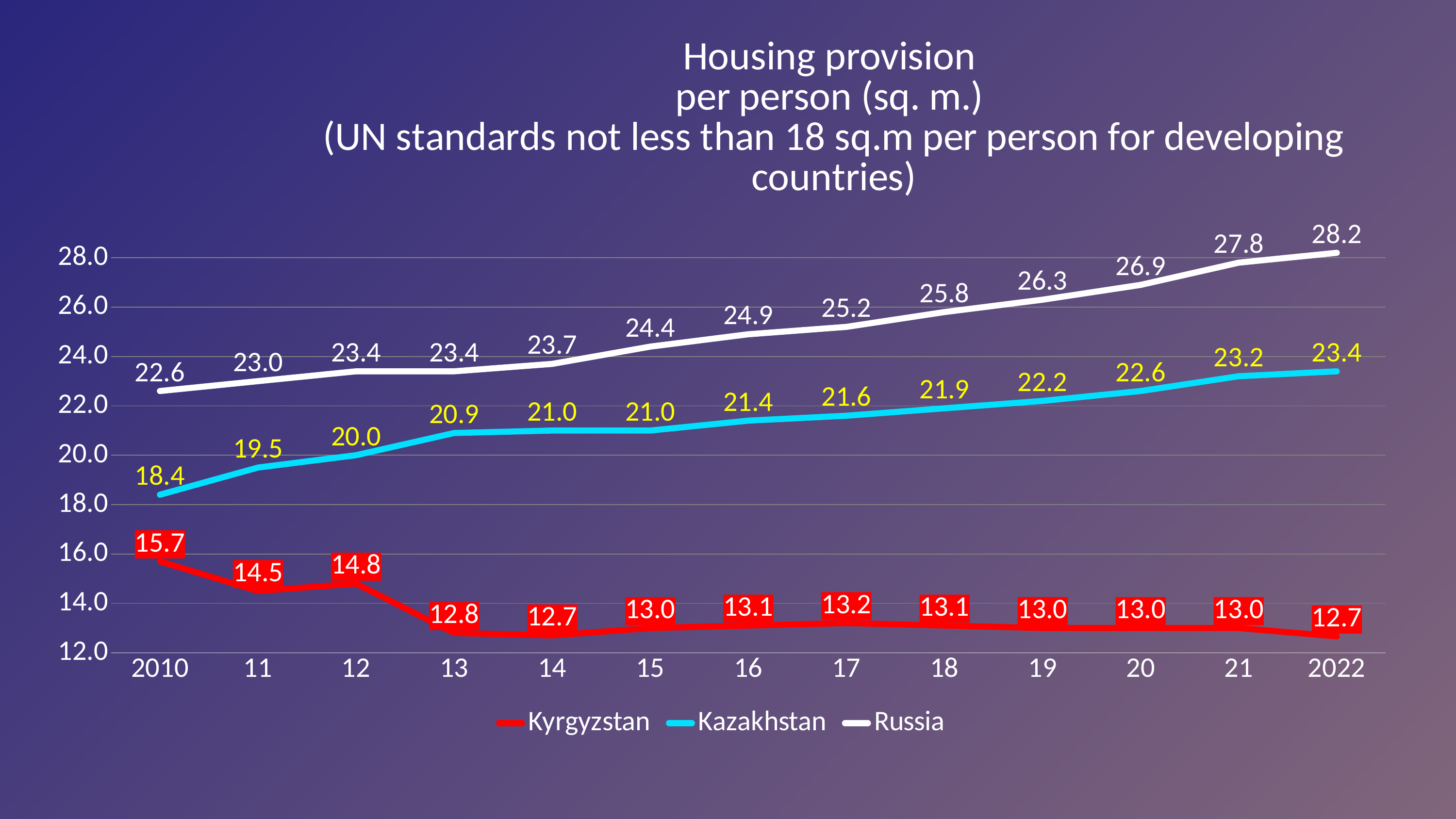
What is the housing provision per person for Kazakhstan in 2010? 18.4 In which year is the Russia value lowest? 2010 How many series does the legend list? 3 In which year is the Kyrgyzstan value highest? 2010 Does the Russia series rise or fall from 2010 to 2022? Rise Which colour is used for the Kazakhstan series? Cyan What is the housing provision per person for Russia in 2022? 28.2 What is the housing provision per person for Kyrgyzstan in 17? 13.2 How many years are shown on the x axis? 13 What is the difference between the Russia and Kazakhstan values in 2022? 4.8 Which is larger in 2010: the Kazakhstan value or the Kyrgyzstan value? Kazakhstan What kind of chart is shown on the slide? Line chart